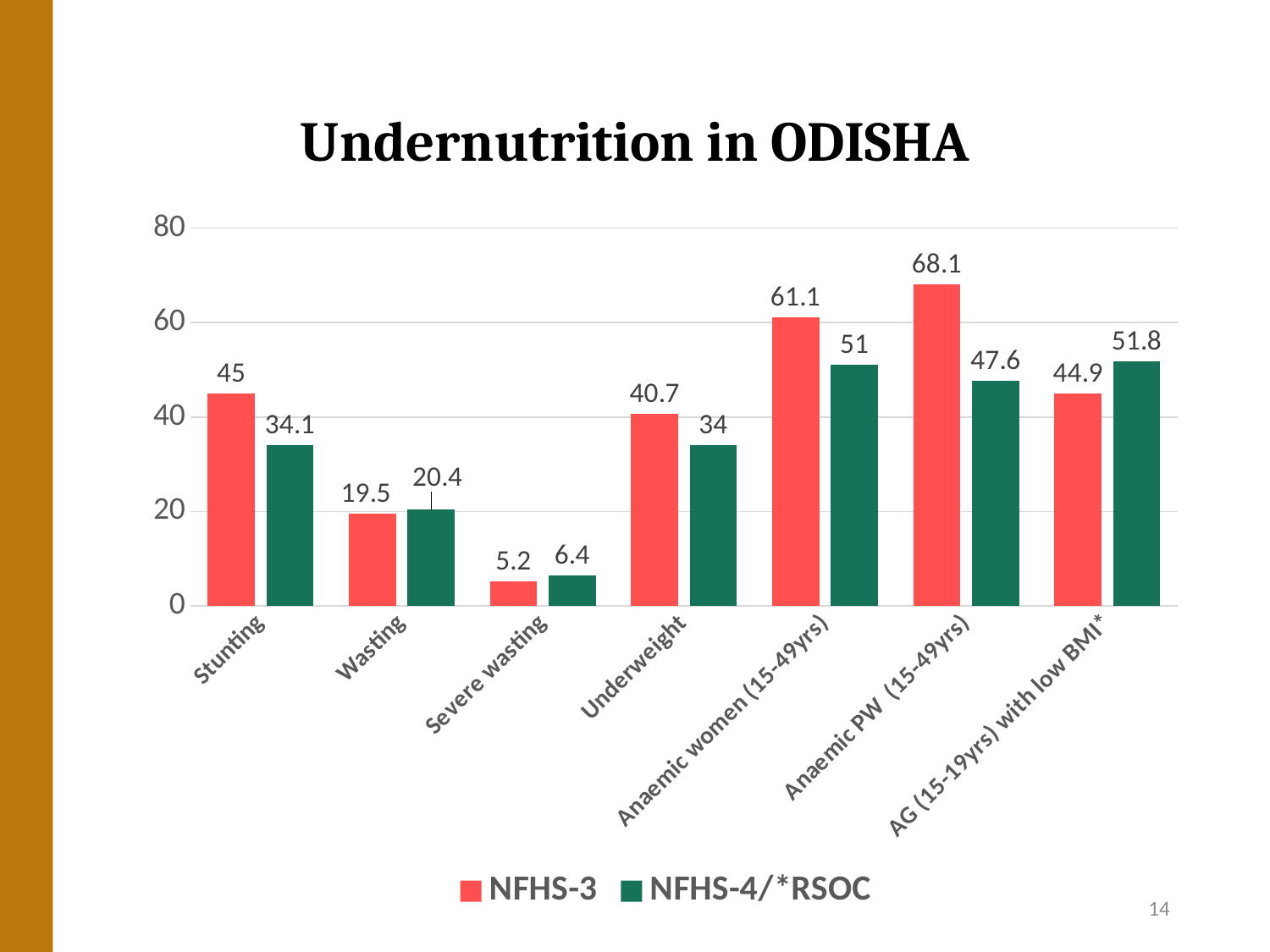
What is the title of the chart? Undernutrition in ODISHA Which category has the lowest NFHS-4/*RSOC value? Severe wasting What is the NFHS-4/*RSOC value for Underweight? 34 Which is larger for Wasting: the NFHS-3 value or the NFHS-4/*RSOC value? NFHS-4/*RSOC How many categories are shown on the x axis? 7 Is the NFHS-3 value for Underweight greater or less than 40? greater Which category has the highest NFHS-3 value? Anaemic PW (15-49yrs) How many series does the legend list? 2 What is the NFHS-3 value for Stunting? 45 What is the difference between the NFHS-3 and NFHS-4/*RSOC values for Anaemic women (15-49yrs)? 10.1 What kind of chart is shown on the slide? Bar chart What is the NFHS-4/*RSOC value for Anaemic PW (15-49yrs)? 47.6